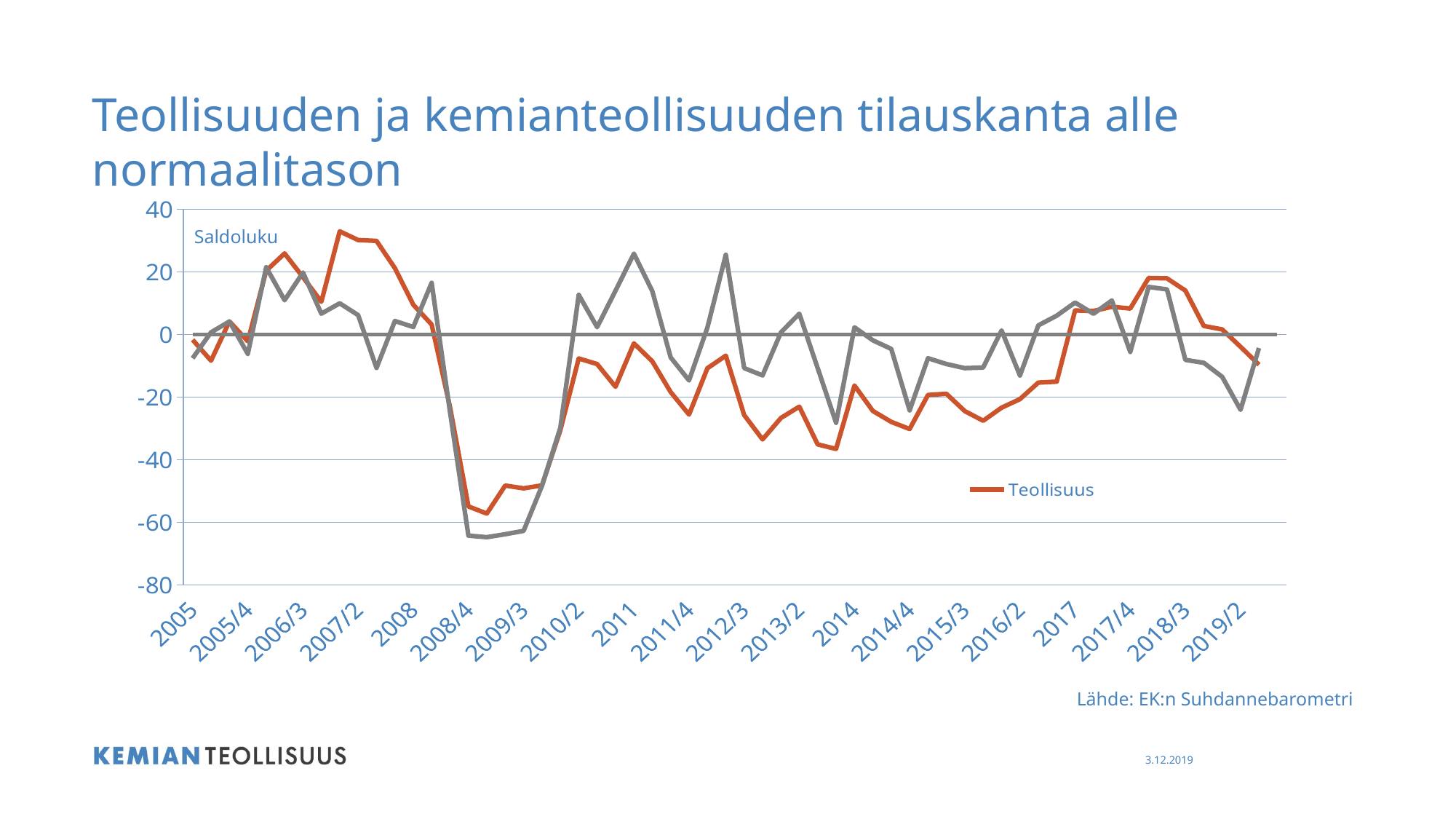
Is the value for Teollisuus at 2012/3 greater or less than -20? less How many series does the chart legend list? 1 What kind of chart is shown on the slide? line chart Is the value for Teollisuus at 2007/2 greater or less than 20? greater Is the value for Teollisuus at 2017/4 greater or less than 0? greater What label is shown at the top of the y axis? Saldoluku What is the title of the slide's chart? Teollisuuden ja kemianteollisuuden tilauskanta alle normaalitason Does the Teollisuus line rise or fall between 2008 and 2008/4? fall